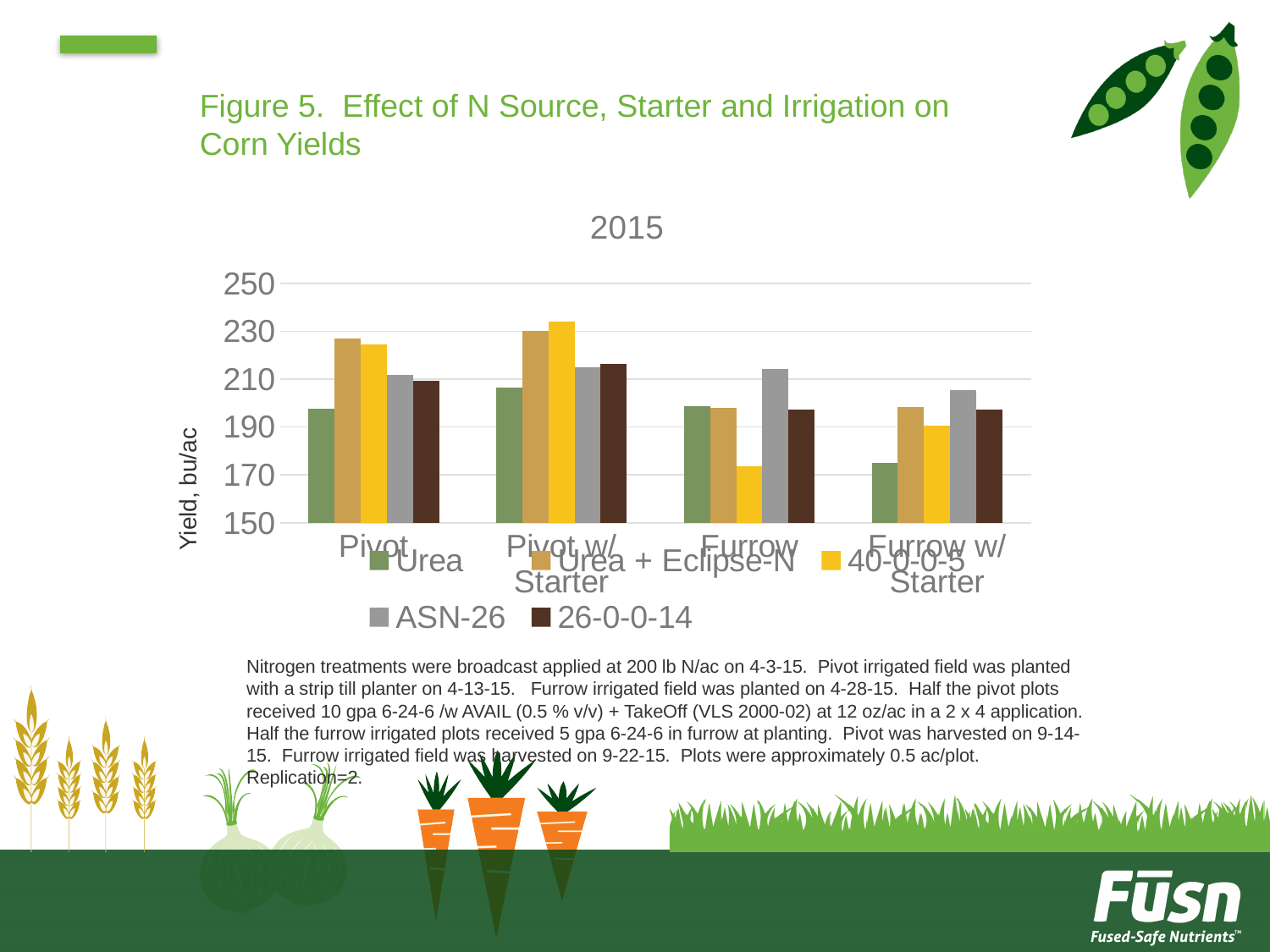
Is the Urea value for Pivot greater or less than 210? less Is the 40-0-0-5 value for Pivot w/ Starter greater or less than 210? greater How many categories are shown along the x axis of the chart? 4 Is the 40-0-0-5 value for Furrow greater or less than 190? less For Pivot, which is larger: the Urea value or the Urea + Eclipse-N value? Urea + Eclipse-N What kind of chart is shown on the slide? bar chart What is the label on the chart's y axis? Yield, bu/ac How many series does the chart's legend list? 5 In the Furrow w/ Starter category, which series has the lowest yield? Urea In the Furrow category, which series has the lowest yield? 40-0-0-5 In the Furrow category, which series has the highest yield? ASN-26